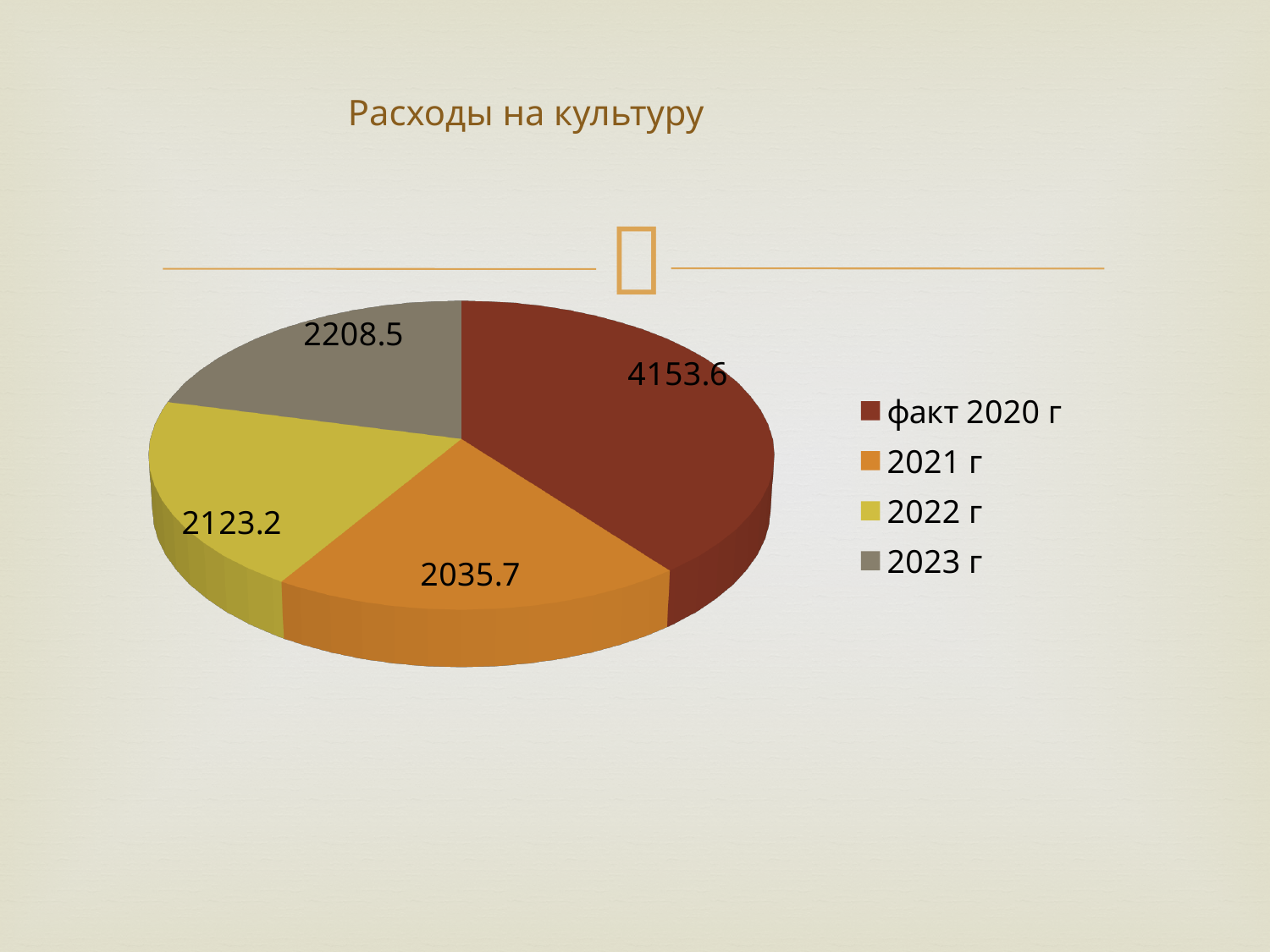
Which category has the largest slice? факт 2020 г What is the title of the chart? Расходы на культуру What is the value for факт 2020 г? 4153.6 Which is larger, the value for 2022 г or the value for 2023 г? 2023 г How many entries does the legend list? 4 Which category has the smallest slice? 2021 г What is the difference between the values for факт 2020 г and 2021 г? 2117.9 How many slices does the pie chart have? 4 What type of chart is shown on the slide? pie chart What is the value for 2022 г? 2123.2 What is the value for 2021 г? 2035.7 What is the value for 2023 г? 2208.5